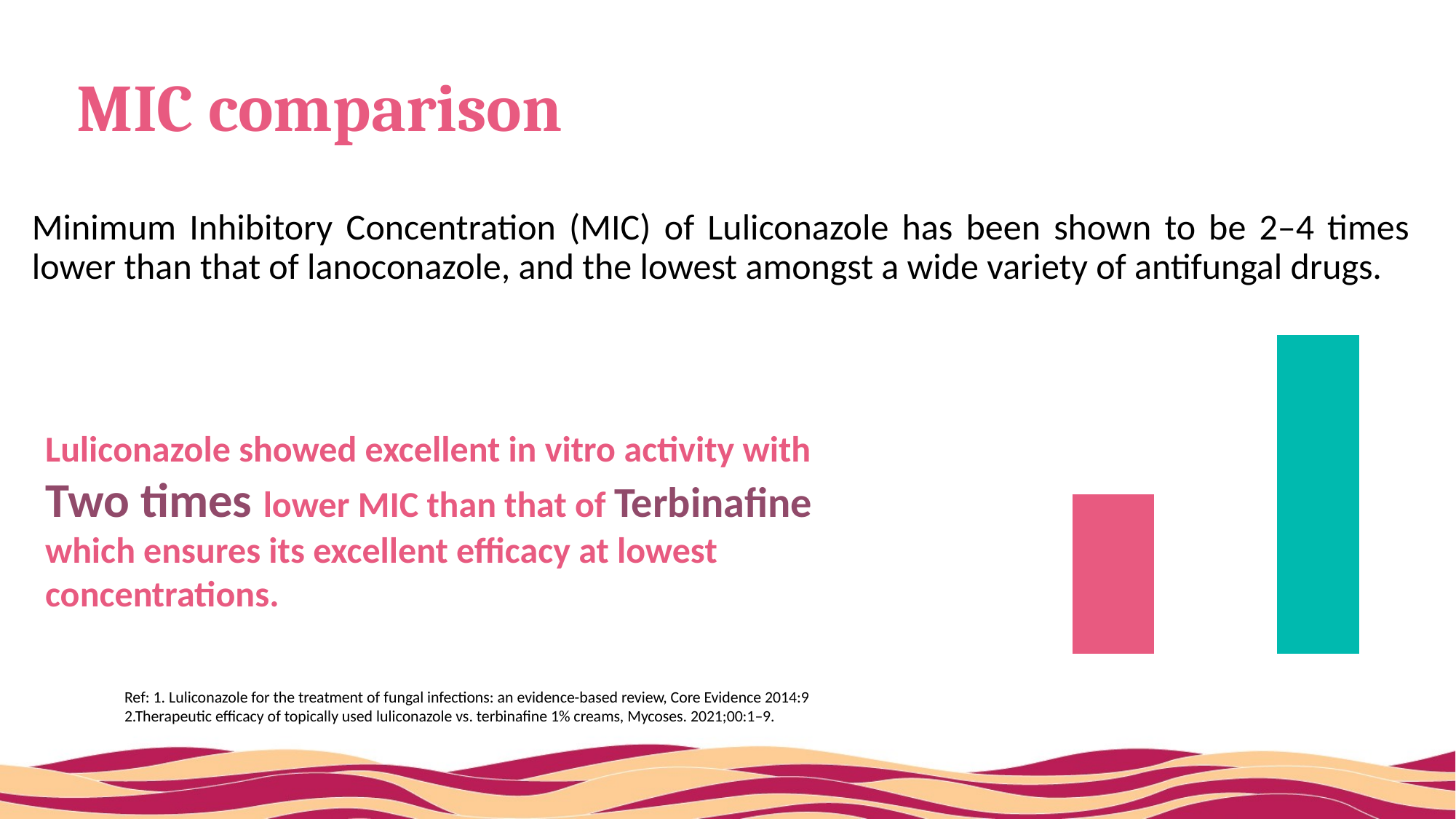
Does the chart on the right side of the slide display any axis labels or data labels? No In the chart on the right side of the slide, which bar is taller, the pink bar on the left or the teal bar on the right? the teal bar on the right What kind of chart is shown on the right side of the slide? bar chart How many bars does the chart on the right side of the slide contain? 2 What colour is the left bar in the chart on the right side of the slide? pink In the chart on the right side of the slide, which bar is shorter, the pink one or the teal one? the pink one